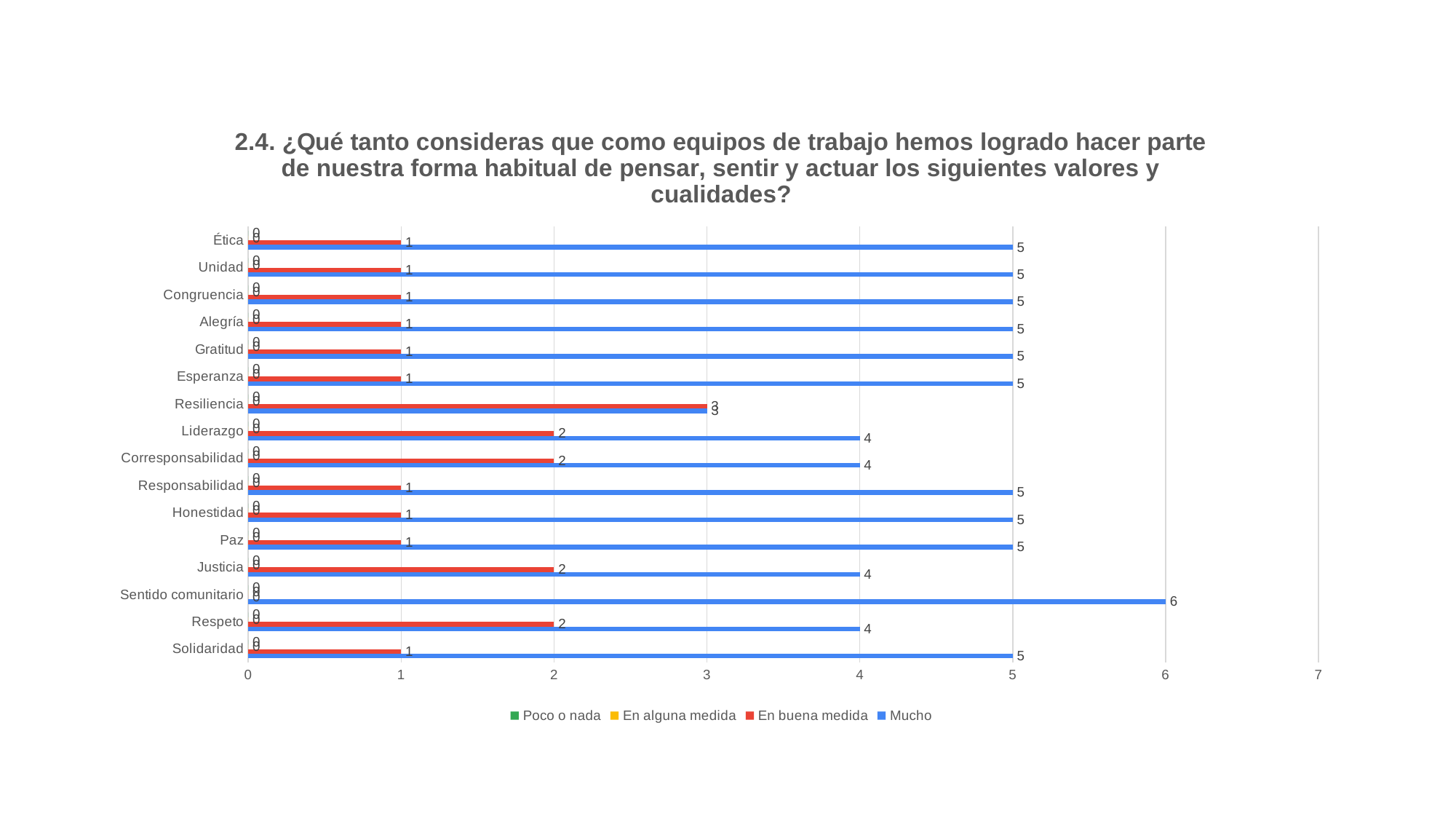
What kind of chart is shown on the slide? Bar chart Which colour represents the "Mucho" series? Blue What is the value of "Mucho" for Resiliencia? 3 Which is larger: the "Mucho" value for Justicia or the "Mucho" value for Paz? Paz Which category has the lowest value for "Mucho"? Resiliencia How many categories are shown on the chart? 16 What is the value of "Mucho" for Sentido comunitario? 6 How many series does the legend list? 4 What is the value of "En buena medida" for Liderazgo? 2 What is the value of "En buena medida" for Ética? 1 What is the difference between the "Mucho" values for Sentido comunitario and Respeto? 2 Which category has the highest value for "Mucho"? Sentido comunitario